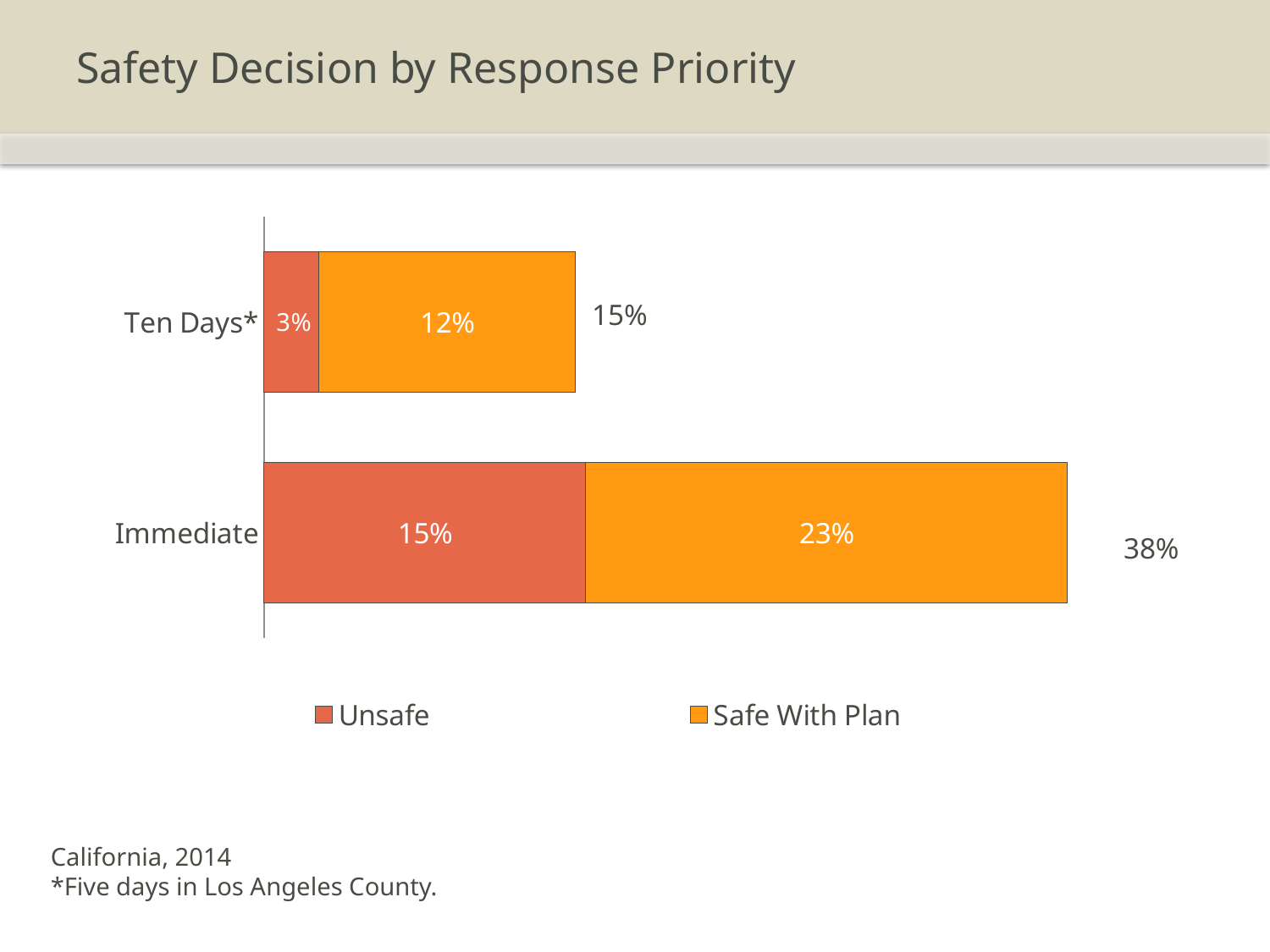
What is the Unsafe value for Immediate? 15% Which category has the higher Safe With Plan value? Immediate What is the total of the stacked bar for Immediate? 38% What is the Safe With Plan value for Ten Days*? 12% How many series does the legend list? 2 What is the total of the stacked bar for Ten Days*? 15% What is the Unsafe value for Ten Days*? 3% Is the Unsafe value for Immediate larger or smaller than the Unsafe value for Ten Days*? larger What is the Safe With Plan value for Immediate? 23% Which category has the lower Unsafe value? Ten Days* What kind of chart is shown? stacked bar chart What is the difference between the Safe With Plan values for Immediate and Ten Days*? 11%